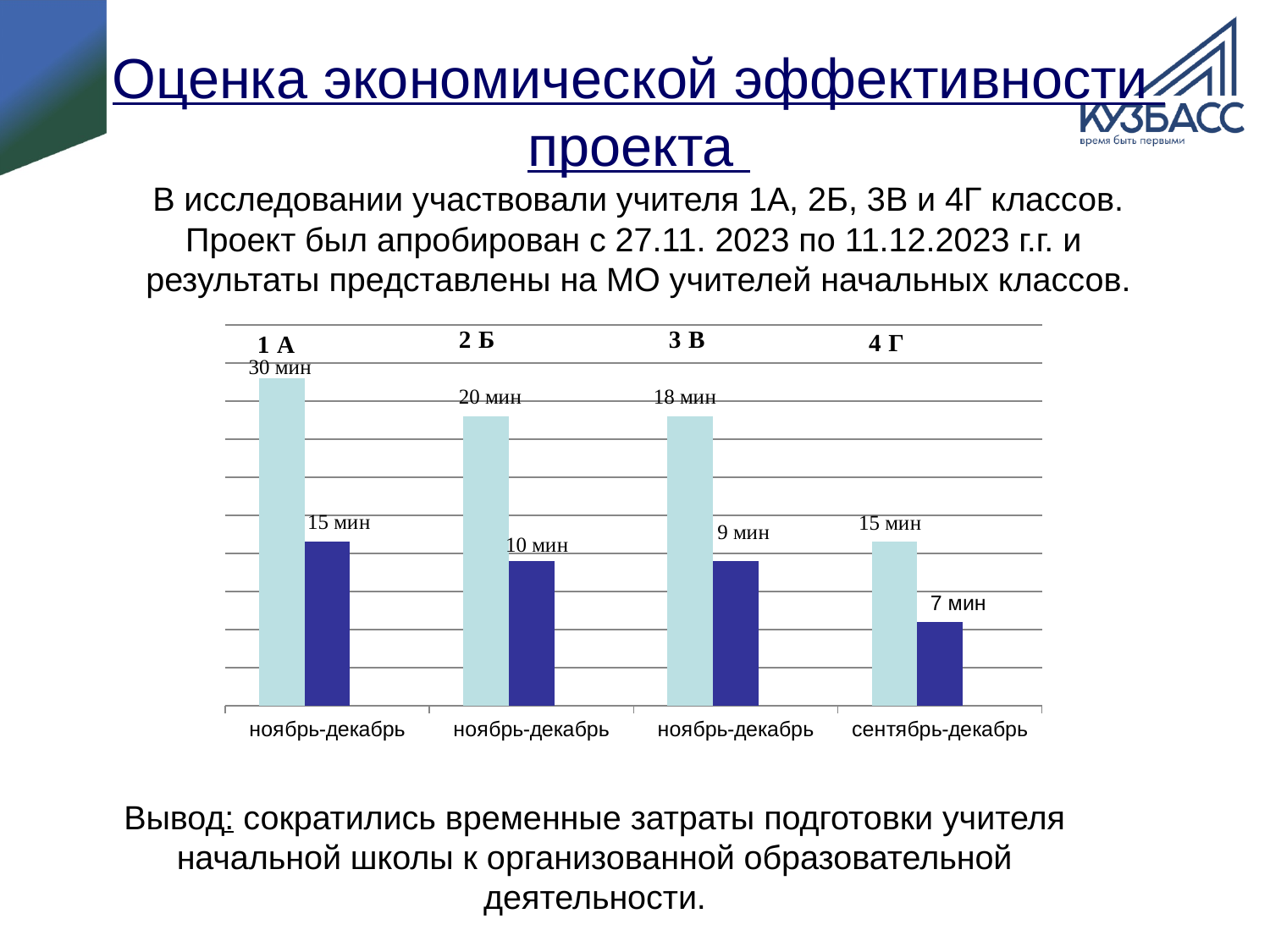
Which class has the lowest dark blue bar? 4 Г What is the value of the light blue bar for class 1 А? 30 мин What type of chart is shown on the slide? Bar chart What is the x-axis label under the bars for class 4 Г? сентябрь-декабрь Which is larger: the dark blue bar for class 1 А or the light blue bar for class 4 Г? They are equal (15 мин) What is the value of the dark blue bar for class 4 Г? 7 мин What is the value of the light blue bar for class 3 В? 18 мин Which class has the highest light blue bar? 1 А What is the difference between the light blue bars for class 2 Б and class 4 Г? 5 мин How many classes (groups of bars) are shown in the chart? 4 What is the difference between the light blue and dark blue bars for class 1 А? 15 мин What is the value of the dark blue bar for class 2 Б? 10 мин